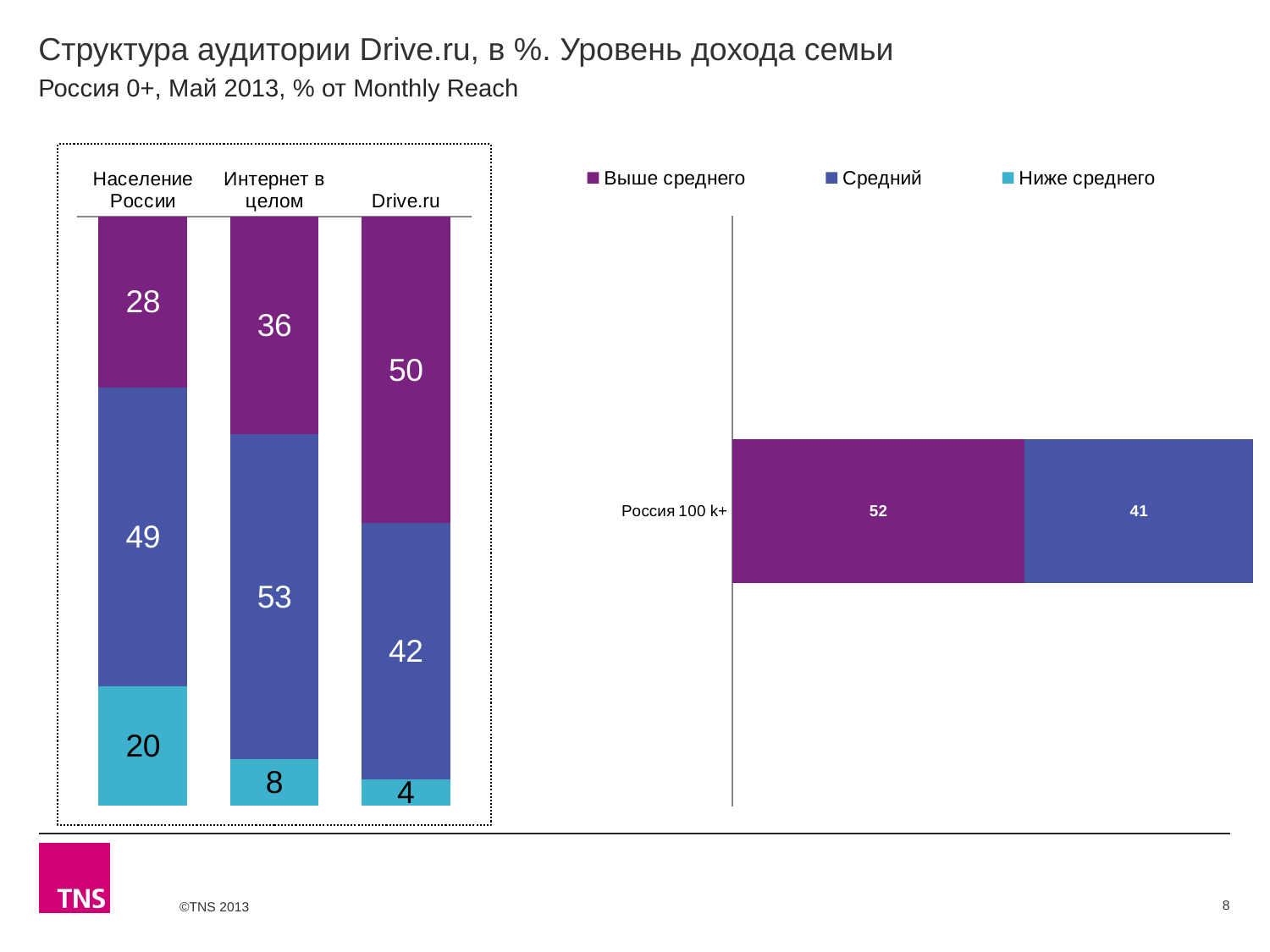
In the left chart, which category has the lowest Ниже среднего value? Drive.ru In the left chart, what is the value of the Средний segment for Интернет в целом? 53 In the left chart, how many categories are shown on the x axis? 3 In the left chart, which is larger: the Средний value for Население России or for Drive.ru? Население России In the left chart, which category has the highest Выше среднего value? Drive.ru In the left chart, what is the difference between the Выше среднего values for Drive.ru and Население России? 22 What type of chart is the left chart? Stacked bar chart How many series does the legend list? 3 In the right chart, what is the value of the Средний segment for Россия 100 k+? 41 In the right chart, what is the value of the Выше среднего segment for Россия 100 k+? 52 In the left chart, what is the value of the Выше среднего segment for Drive.ru? 50 In the left chart, what is the value of the Ниже среднего segment for Население России? 20